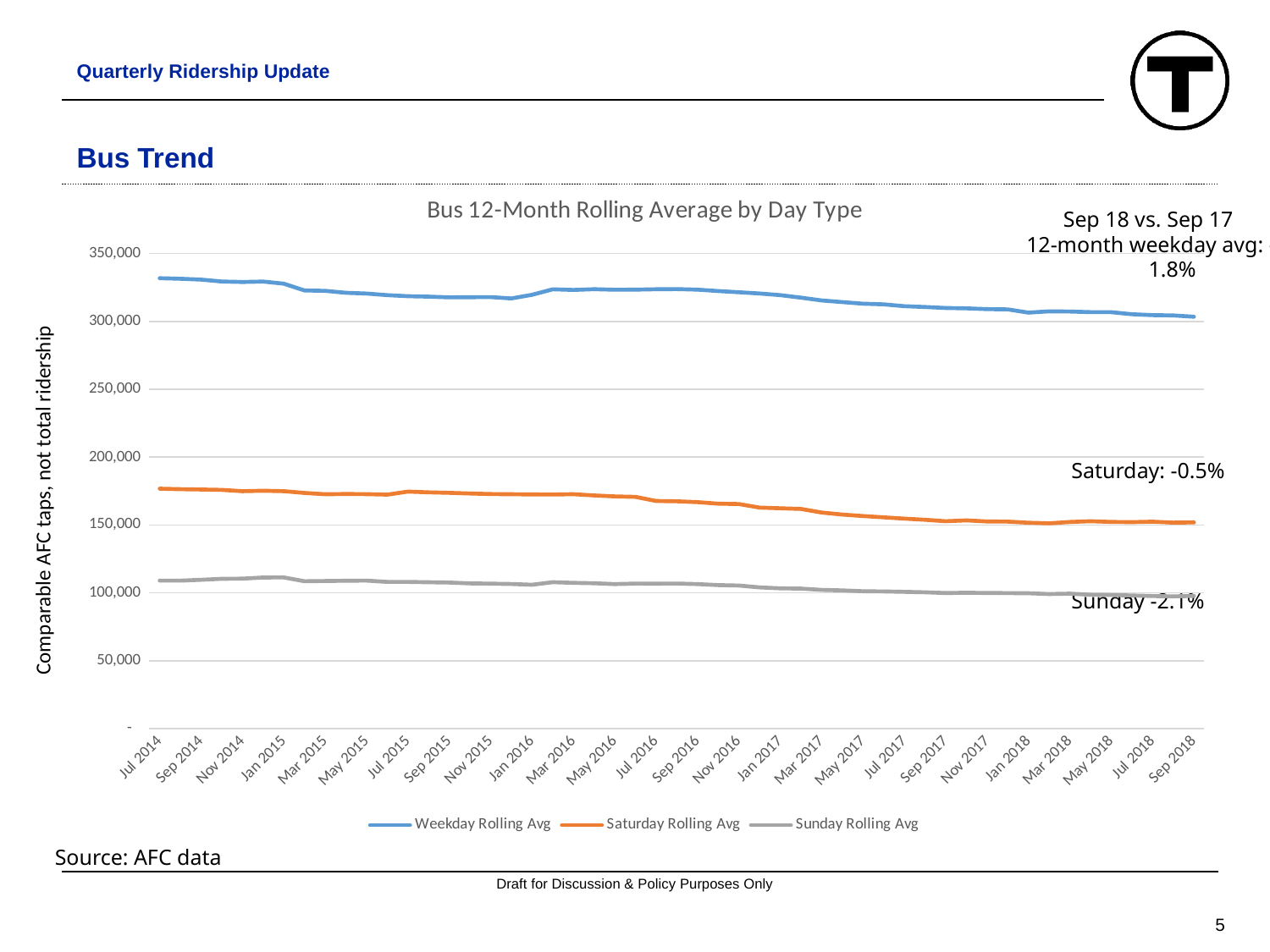
How many series does the legend list? 3 Is the Saturday Rolling Avg in Jul 2014 greater or less than 200,000? less Which series has the highest values throughout the chart? Weekday Rolling Avg Which is larger in Sep 2018, the Saturday Rolling Avg or the Sunday Rolling Avg? Saturday Rolling Avg Does the Saturday Rolling Avg rise or fall from Jul 2014 to Sep 2018? fall According to the annotation on the chart, what is the Saturday change for Sep 18 vs. Sep 17? -0.5% Is the Sunday Rolling Avg in Jul 2014 greater or less than 100,000? greater Which series has the lowest values throughout the chart? Sunday Rolling Avg Is the Weekday Rolling Avg in Jul 2014 greater or less than 300,000? greater What kind of chart is shown on the slide? line chart What is the title of the chart? Bus 12-Month Rolling Average by Day Type Does the Weekday Rolling Avg rise or fall from Jul 2014 to Sep 2018? fall